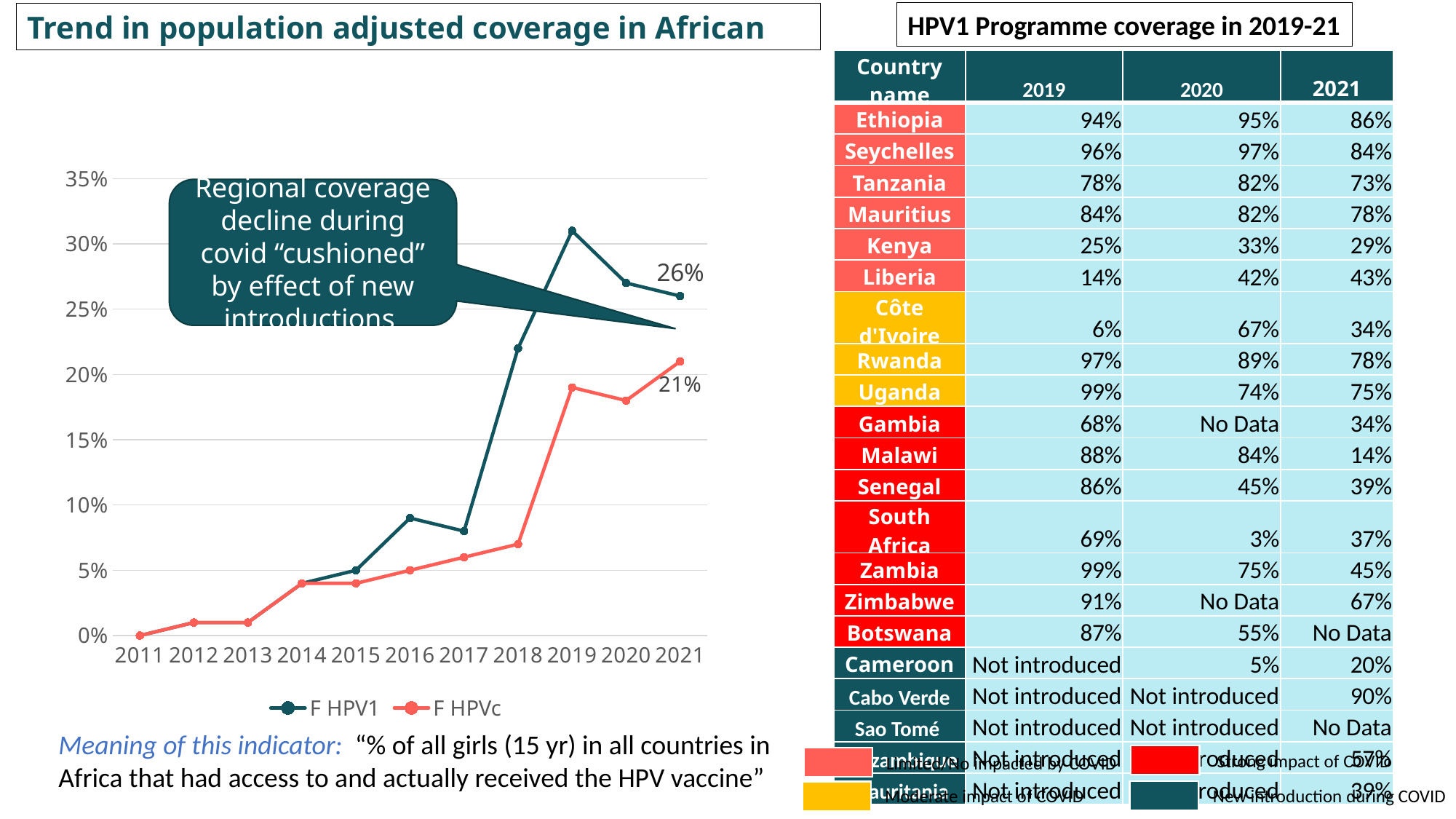
In 2021, what is the difference between the F HPV1 and F HPVc values in the line chart? 5 percentage points How many years are shown on the x axis of the line chart? 11 How many series does the legend of the line chart list? 2 What is the F HPV1 value for 2021 in the line chart? 26% Is the F HPV1 value for 2017 greater or less than 10%? less Does the F HPVc series generally rise or fall from 2011 to 2021? rise In which year does the F HPV1 series reach its highest value in the line chart? 2019 In 2021, which series has the higher value in the line chart, F HPV1 or F HPVc? F HPV1 What is the F HPVc value for 2021 in the line chart? 21% Is the F HPVc value for 2018 greater or less than 10%? less What kind of chart is shown on the left of the slide? Line chart Is the F HPV1 value for 2019 greater or less than 25%? greater